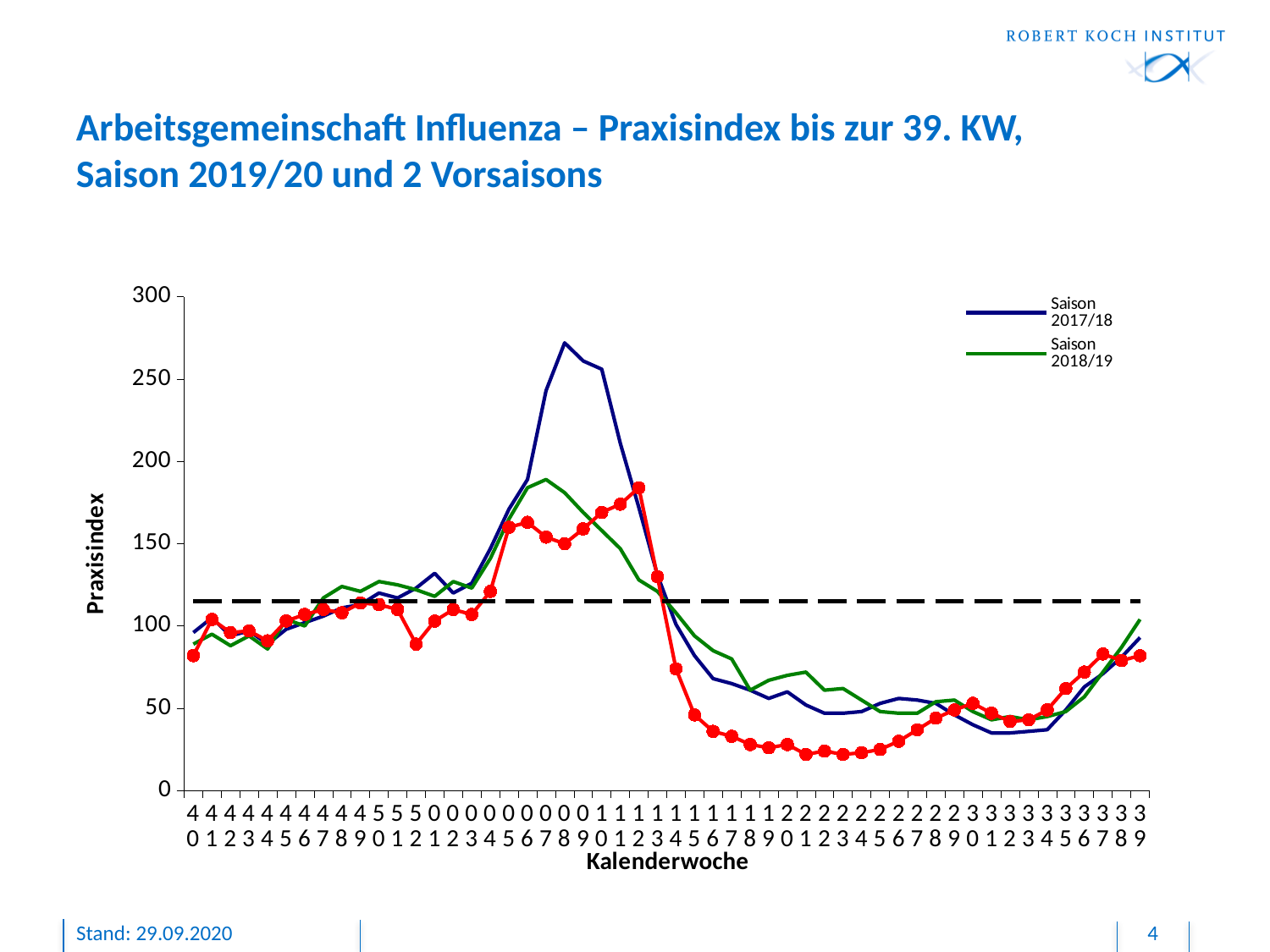
At calendar week 08, which series has the higher value, Saison 2017/18 or Saison 2018/19? Saison 2017/18 Is the peak value of the red line with markers greater or less than 200? less Is the peak value of Saison 2017/18 greater or less than 250? greater What is the title of the y axis? Praxisindex What kind of chart is shown on the slide? line chart Which season reaches the highest peak value on the chart? Saison 2017/18 Is the peak value of Saison 2018/19 greater or less than 200? less What is the title of the x axis? Kalenderwoche Between calendar week 08 and calendar week 14, does the Saison 2017/18 line rise or fall? fall How many series does the legend list? 2